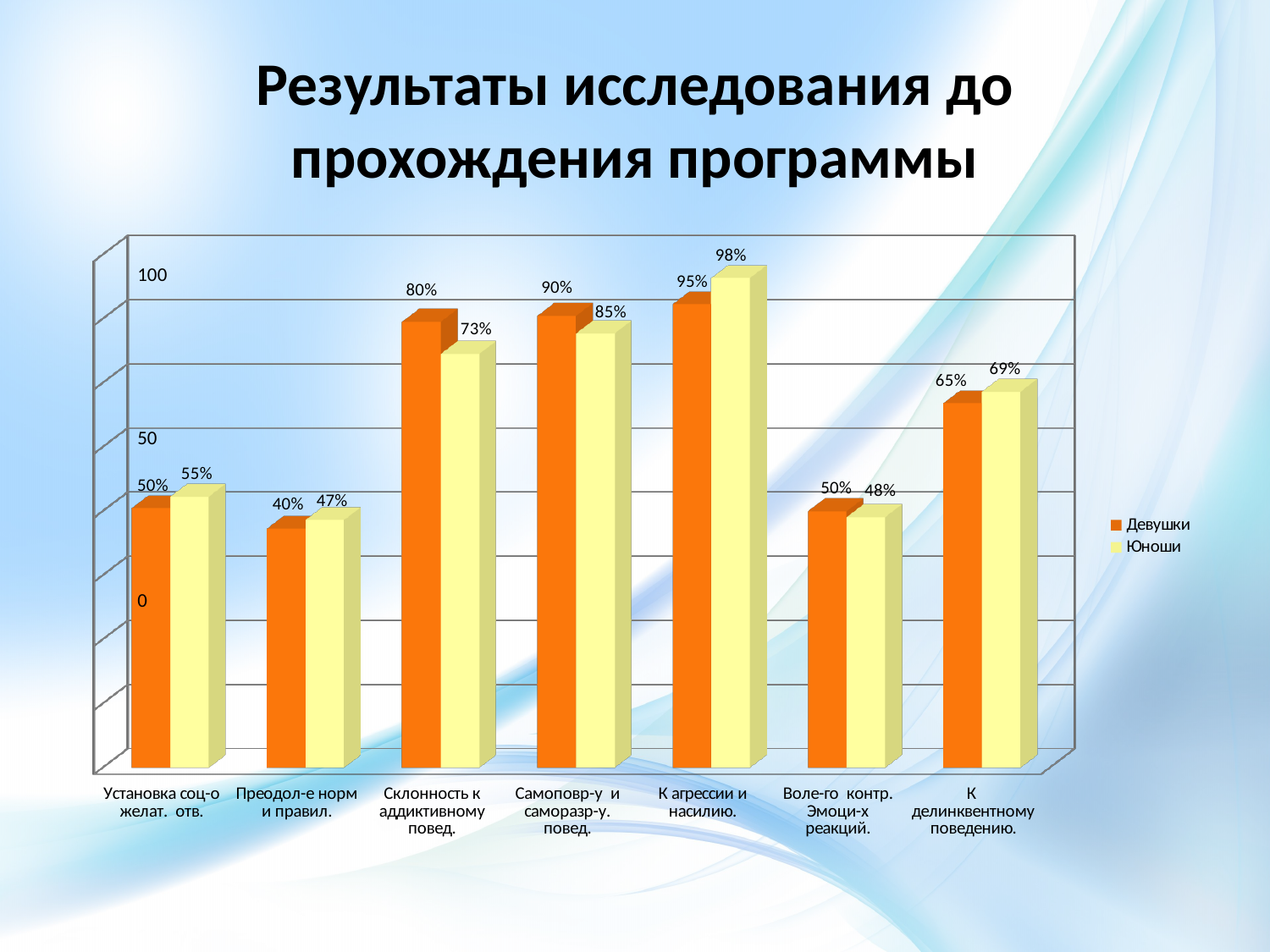
What is the value for Юноши in the category 'К агрессии и насилию.'? 98% Which category has the lowest value for Юноши? Преодол-е норм и правил. What is the title of the slide? Результаты исследования до прохождения программы What kind of chart is shown on the slide? Bar chart What is the value for Девушки in the category 'Преодол-е норм и правил.'? 40% What is the difference between the Девушки and Юноши values in the category 'Склонность к аддиктивному повед.'? 7% In the category 'Самоповр-у и саморазр-у. повед.', which series has the larger value, Девушки or Юноши? Девушки How many series does the legend list? 2 What is the value for Девушки in the category 'Склонность к аддиктивному повед.'? 80% What is the value for Юноши in the category 'К делинквентному поведению.'? 69% Which category has the highest value for Девушки? К агрессии и насилию. How many categories are shown on the x axis of the chart? 7